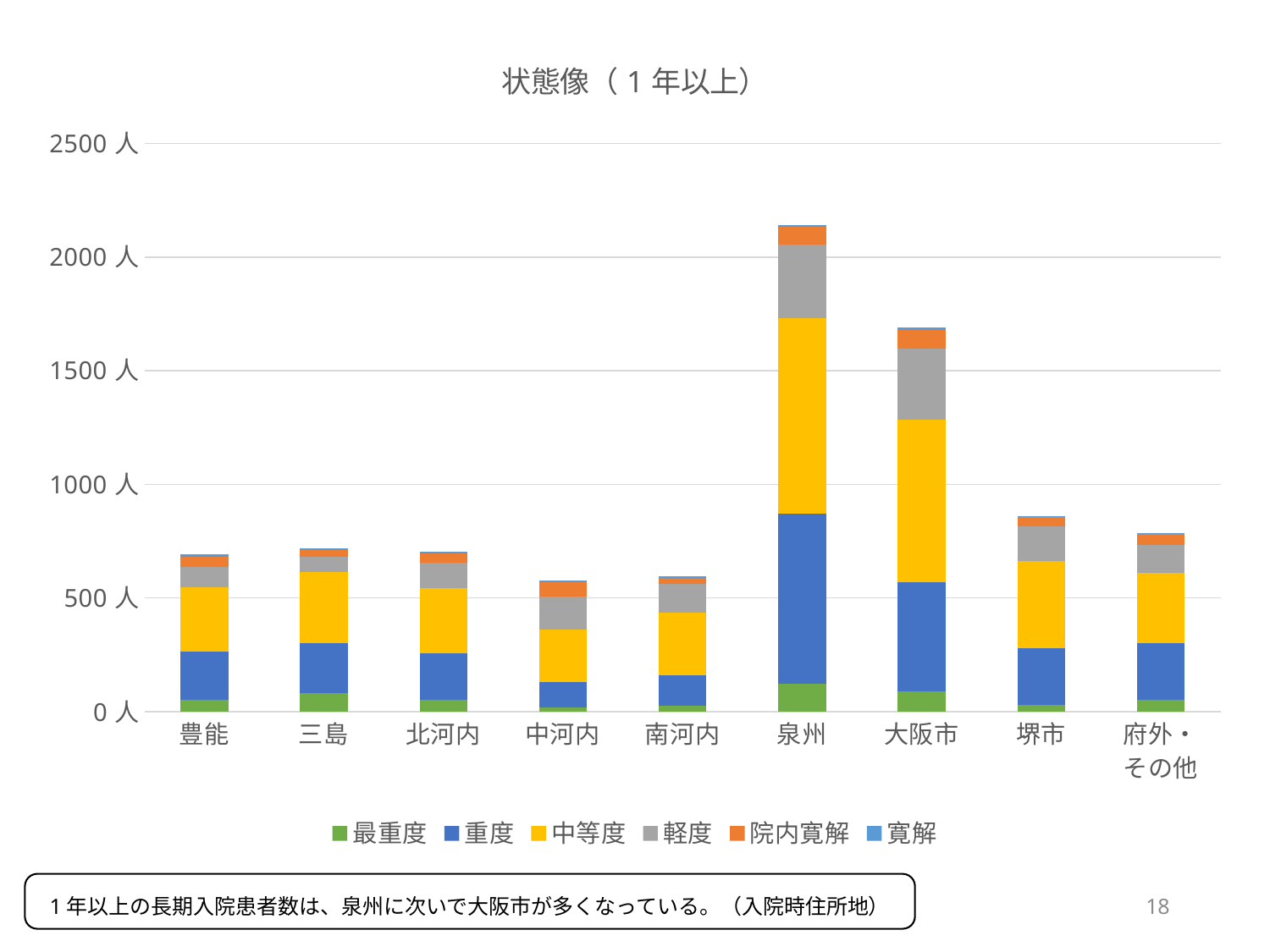
Is the total for 中河内 greater or less than 500人? greater Which has the larger total, 堺市 or 豊能? 堺市 Which category has the tallest stacked bar? 泉州 Which colour represents the 中等度 series in the legend? Yellow Is the total for 大阪市 greater or less than 2000人? less Is the total for 堺市 greater or less than 1000人? less What is the title of the chart? 状態像（1年以上） What kind of chart is shown on the slide? Stacked bar chart How many categories are shown on the x axis? 9 Which has the larger total, 泉州 or 大阪市? 泉州 How many series does the legend list? 6